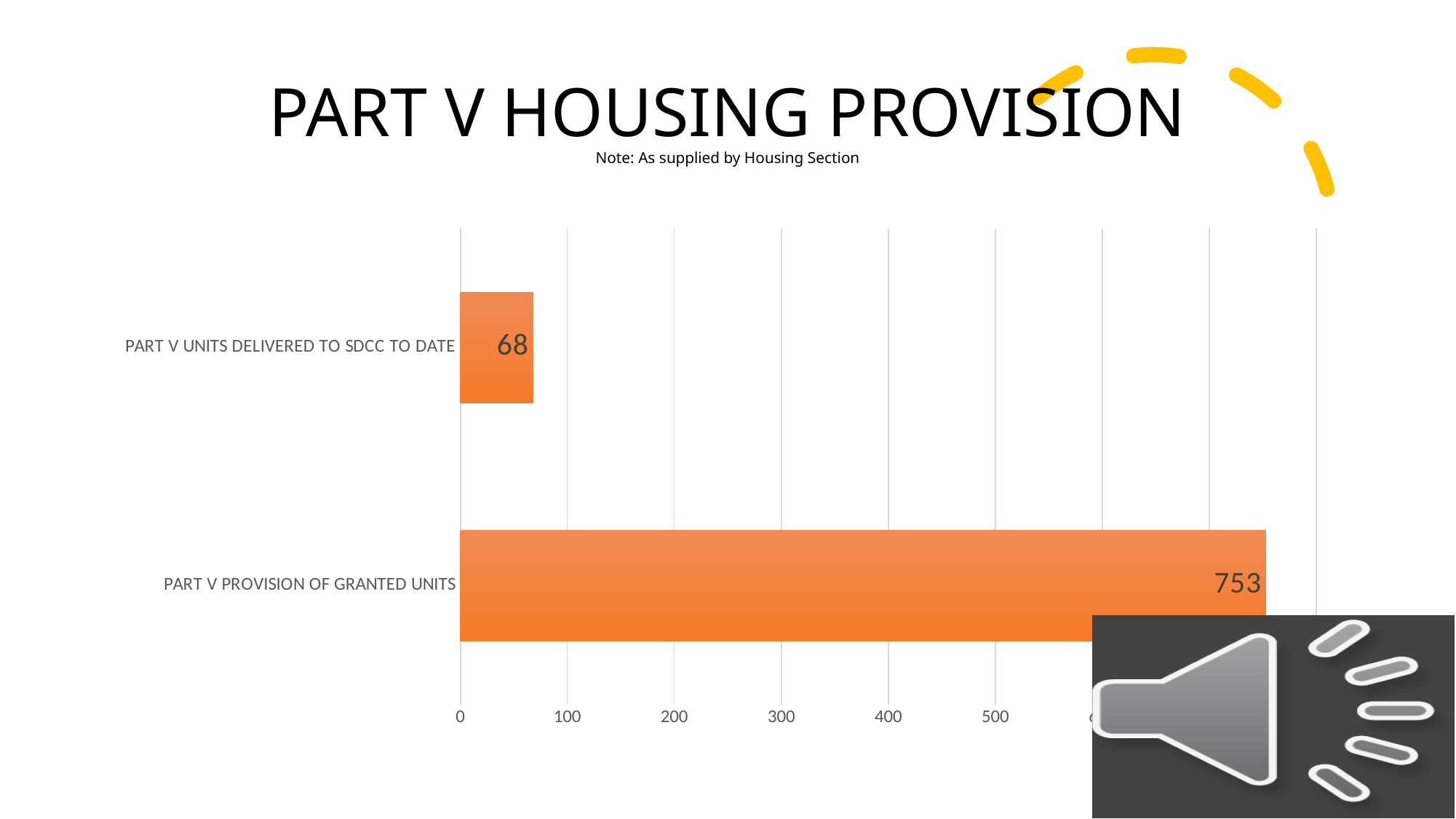
What colour are the bars in the chart? orange Is the value for PART V UNITS DELIVERED TO SDCC TO DATE greater or less than 100? less Is the value for PART V PROVISION OF GRANTED UNITS greater or less than 500? greater Which category has the lowest value? PART V UNITS DELIVERED TO SDCC TO DATE What is the title of the slide containing the chart? PART V HOUSING PROVISION Which is larger: the value for PART V UNITS DELIVERED TO SDCC TO DATE or the value for PART V PROVISION OF GRANTED UNITS? PART V PROVISION OF GRANTED UNITS How many categories are shown in the chart? 2 What kind of chart is shown on the slide? bar chart What is the difference between the value for PART V PROVISION OF GRANTED UNITS and the value for PART V UNITS DELIVERED TO SDCC TO DATE? 685 What is the value for PART V UNITS DELIVERED TO SDCC TO DATE? 68 Which category has the highest value? PART V PROVISION OF GRANTED UNITS What is the value for PART V PROVISION OF GRANTED UNITS? 753